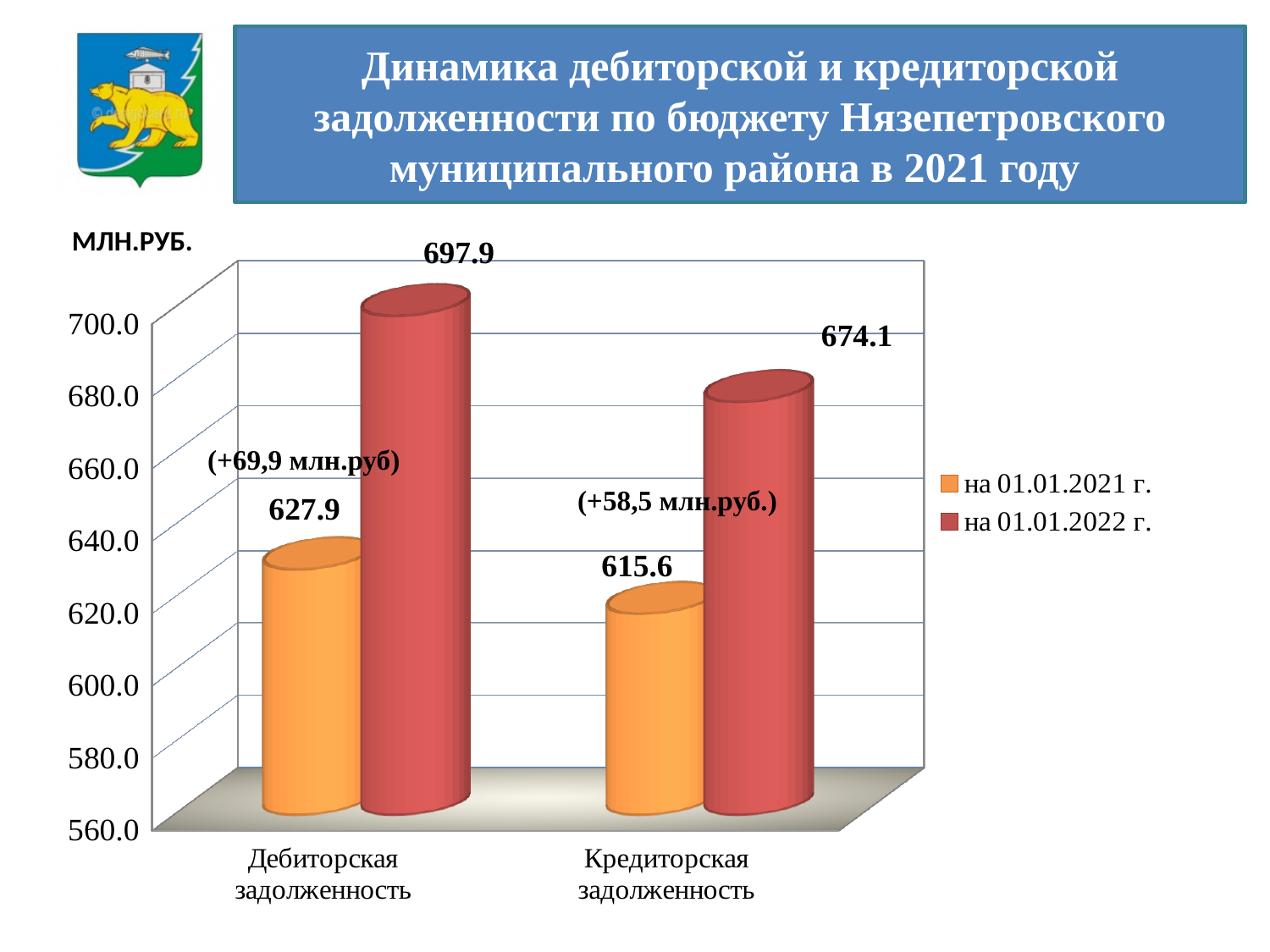
How many categories are shown on the x axis? 2 Which bar has the highest value on the chart? Дебиторская задолженность on 01.01.2022 г. What is the difference between the 01.01.2022 г. and 01.01.2021 г. values for Кредиторская задолженность? 58.5 How many series does the legend list? 2 What kind of chart is shown on the slide? Bar chart What is the difference between the 01.01.2022 г. and 01.01.2021 г. values for Дебиторская задолженность? 70.0 Which bar has the lowest value on the chart? Кредиторская задолженность on 01.01.2021 г. What is the value for Дебиторская задолженность on 01.01.2022 г.? 697.9 What is the value for Дебиторская задолженность on 01.01.2021 г.? 627.9 What is the value for Кредиторская задолженность on 01.01.2021 г.? 615.6 What is the value for Кредиторская задолженность on 01.01.2022 г.? 674.1 Which is larger: Дебиторская задолженность on 01.01.2021 г. or Кредиторская задолженность on 01.01.2022 г.? Кредиторская задолженность on 01.01.2022 г.